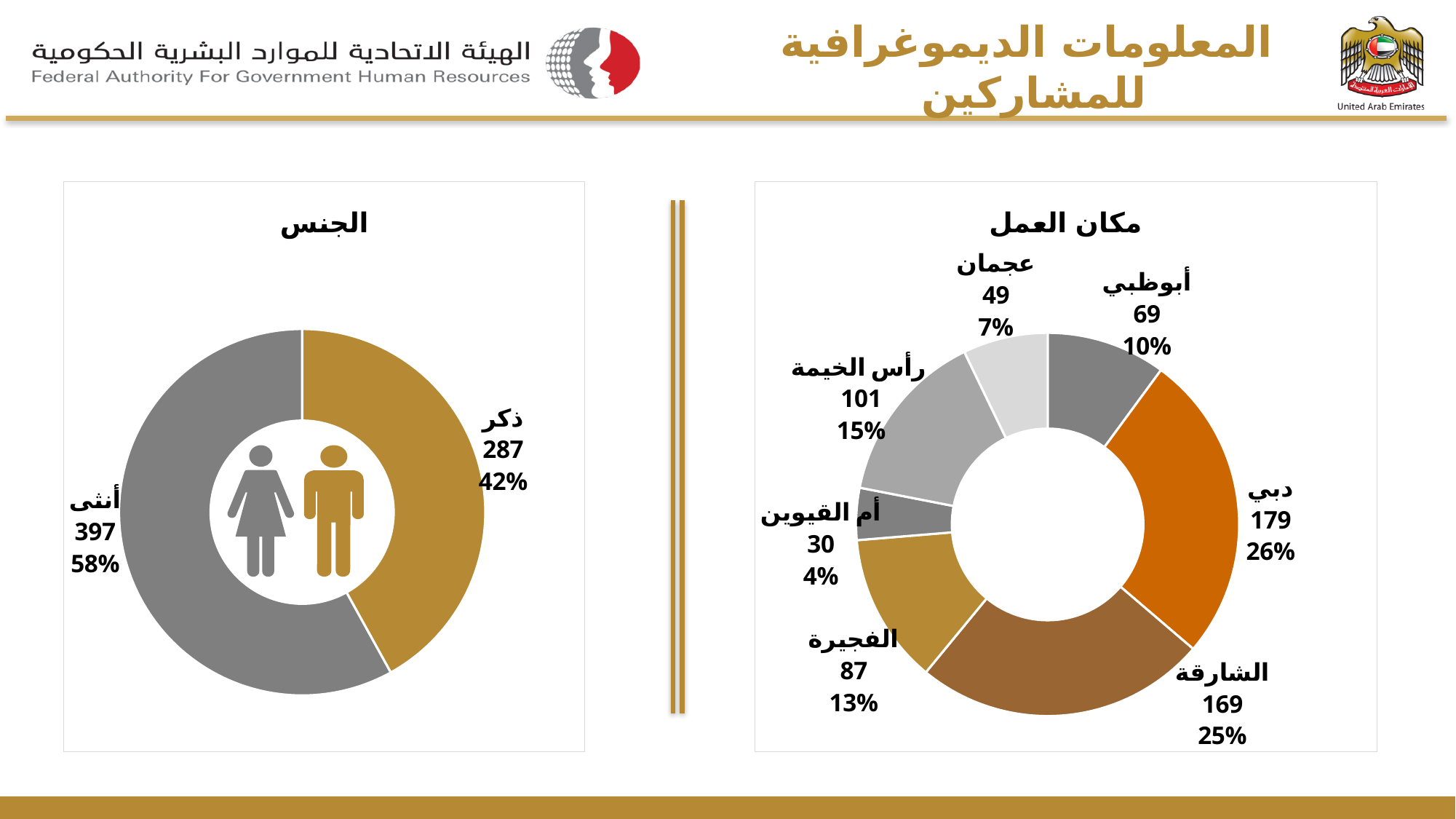
In the chart titled "مكان العمل", which category has the highest count? دبي In the chart titled "الجنس", what is the difference between the counts for "أنثى" and "ذكر"? 110 In the chart titled "مكان العمل", what is the difference between the counts for "الشارقة" and "عجمان"? 120 In the chart titled "الجنس", what is the count for "ذكر"? 287 What is the title of the chart on the left side of the slide? الجنس In the chart titled "مكان العمل", what is the count for "دبي"? 179 In the chart titled "مكان العمل", which category has the lowest count? أم القيوين What kind of chart is the chart titled "مكان العمل"? Donut (pie) chart In the chart titled "مكان العمل", how many categories are shown? 7 In the chart titled "مكان العمل", which is larger, the count for "الفجيرة" or the count for "أبوظبي"? الفجيرة In the chart titled "الجنس", what percentage share does "أنثى" have? 58% In the chart titled "مكان العمل", what percentage share does "رأس الخيمة" have? 15%